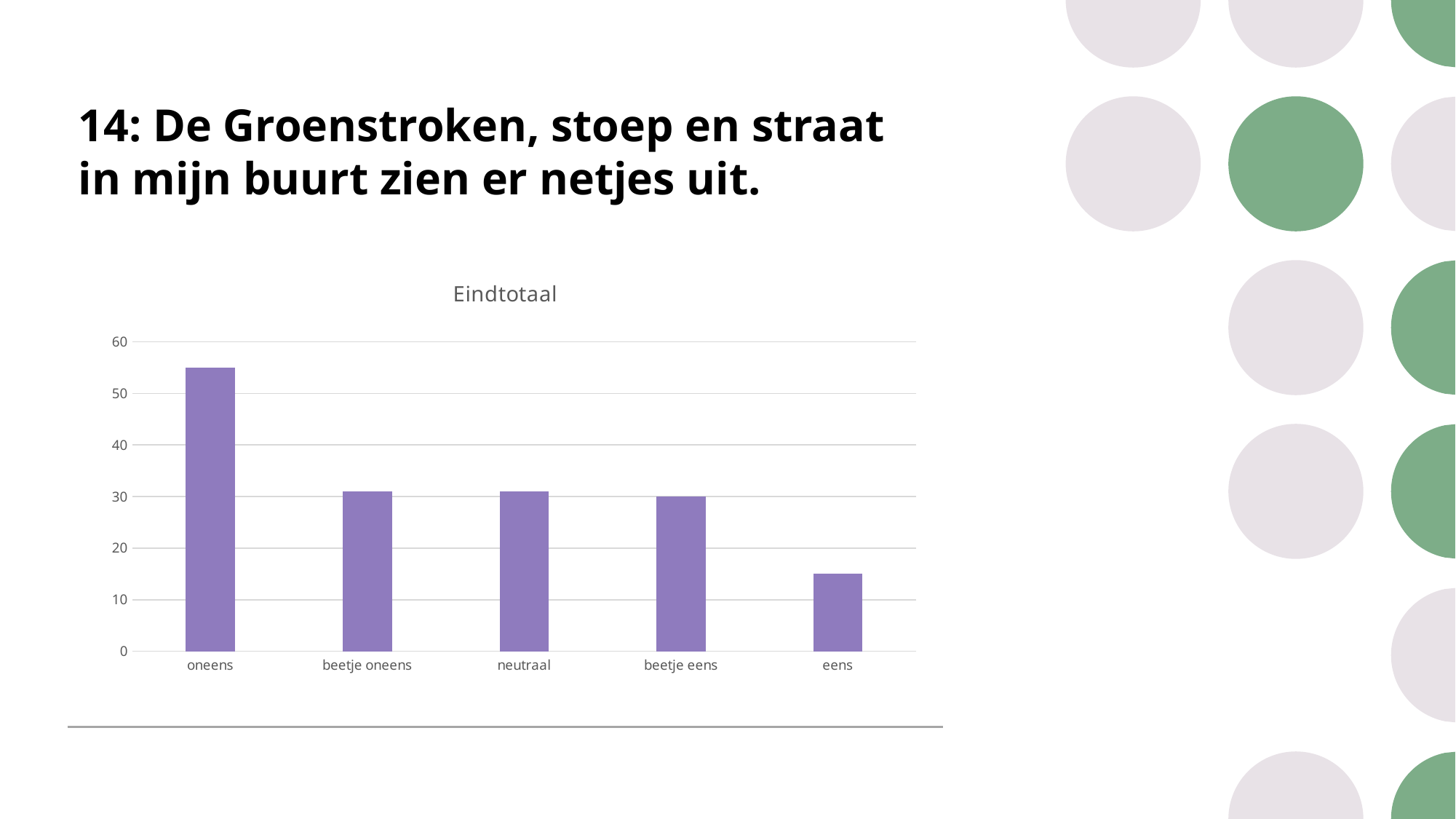
Which category has the lowest value in the chart? eens Which is larger, the value for oneens or the value for eens? oneens Is the value for eens greater or less than 20? less What is the title of the chart? Eindtotaal Is the value for beetje oneens greater or less than 20? greater What kind of chart is shown on the slide? bar chart Is the value for neutraal greater or less than 40? less How many categories are shown on the x axis of the chart? 5 Which category has the highest value in the chart? oneens What colour are the bars in the chart? purple